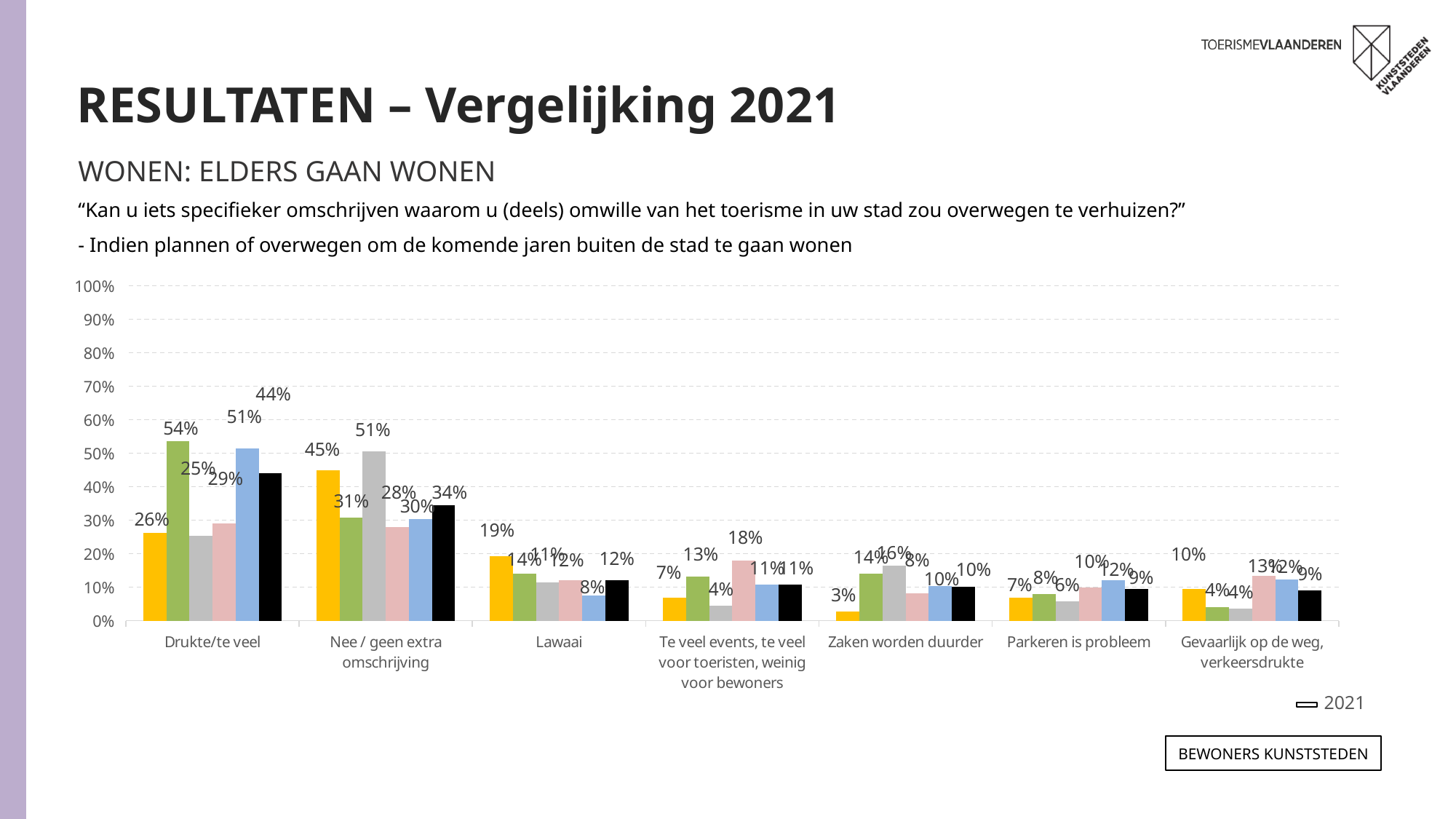
What is the value of the 2021 series for 'Drukte/te veel'? 44% Is the 2021 value for 'Drukte/te veel' greater or less than 40%? greater What is the value of the yellow bar for 'Zaken worden duurder'? 3% What is the value of the 2021 series for 'Nee / geen extra omschrijving'? 34% How many categories are shown on the x axis? 7 Which has the larger 2021 value: 'Parkeren is probleem' or 'Zaken worden duurder'? Zaken worden duurder What is the value of the 2021 series for 'Lawaai'? 12% Which category has the lowest value for the yellow bar? Zaken worden duurder How many entries does the legend list? 1 What kind of chart is shown on the slide? bar chart What is the difference between the 2021 values for 'Drukte/te veel' and 'Nee / geen extra omschrijving'? 10 percentage points Which category has the highest value in the 2021 series? Drukte/te veel